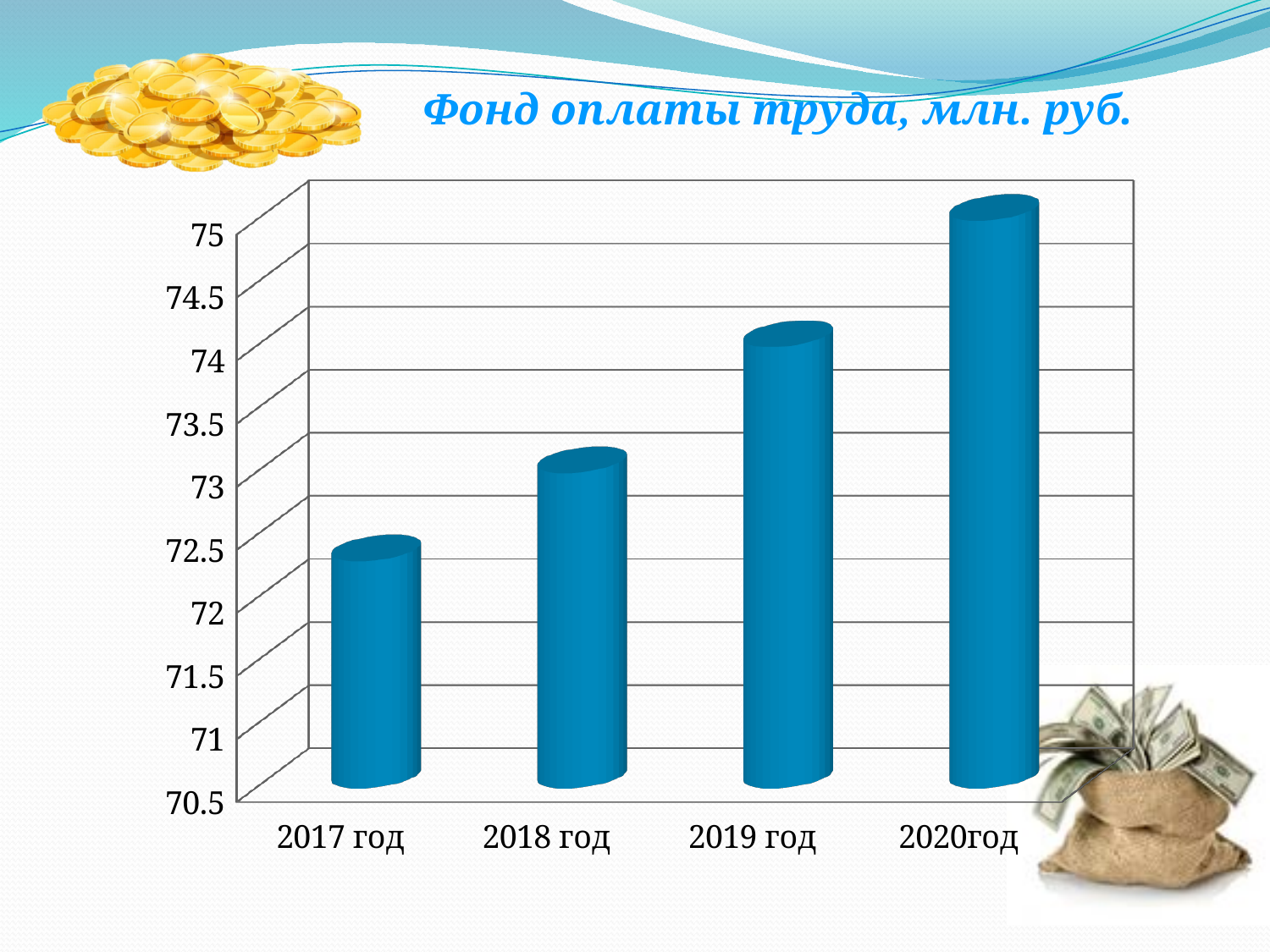
Is the value for 2019 год greater or less than 73.5? greater How many years (categories) are shown on the x axis? 4 Is the value for 2017 год greater or less than 72? greater Is the value for 2017 год greater or less than 73? less Which is larger, the value for 2018 год or the value for 2019 год? 2019 год What is the title of the chart? Фонд оплаты труда, млн. руб. Which year has the highest value? 2020год Do the values rise or fall from 2017 to 2020? rise Which year has the lowest value? 2017 год What kind of chart is shown on the slide? bar chart